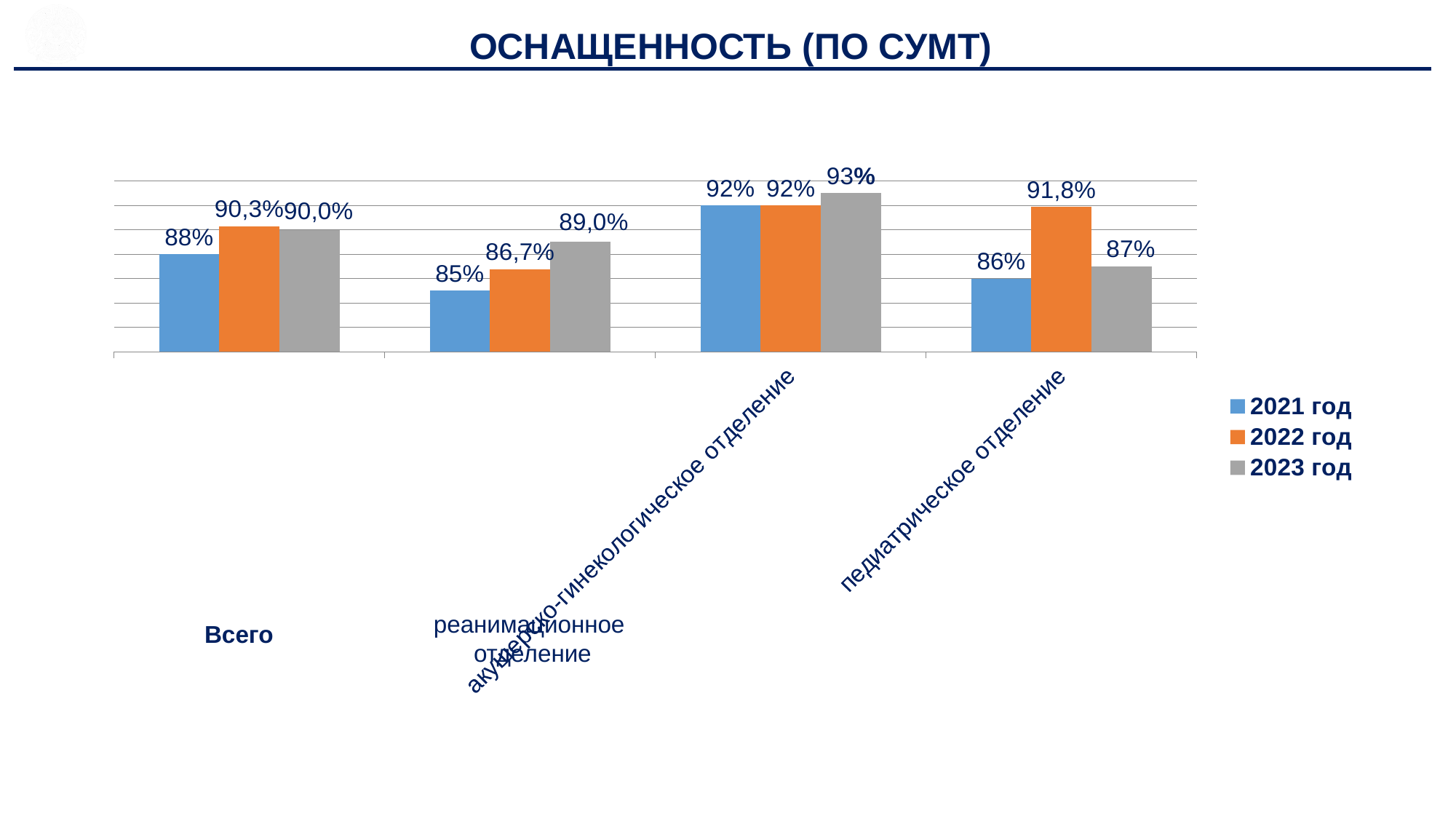
Which category has the highest value in 2023 год? акушерско-гинекологическое отделение Which category has the lowest value in 2021 год? реанимационное отделение What is the value for педиатрическое отделение in 2022 год? 91,8% What is the value for Всего in 2021 год? 88% What is the value for акушерско-гинекологическое отделение in 2023 год? 93% What is the difference between the 2022 год and 2021 год values for педиатрическое отделение? 5,8% What type of chart is shown on the slide? bar chart How many series does the legend list? 3 Which is larger for реанимационное отделение: the 2022 год value or the 2023 год value? 2023 год Do the values for реанимационное отделение rise or fall from 2021 год to 2023 год? rise What is the value for реанимационное отделение in 2023 год? 89,0% How many categories are shown on the x axis? 4